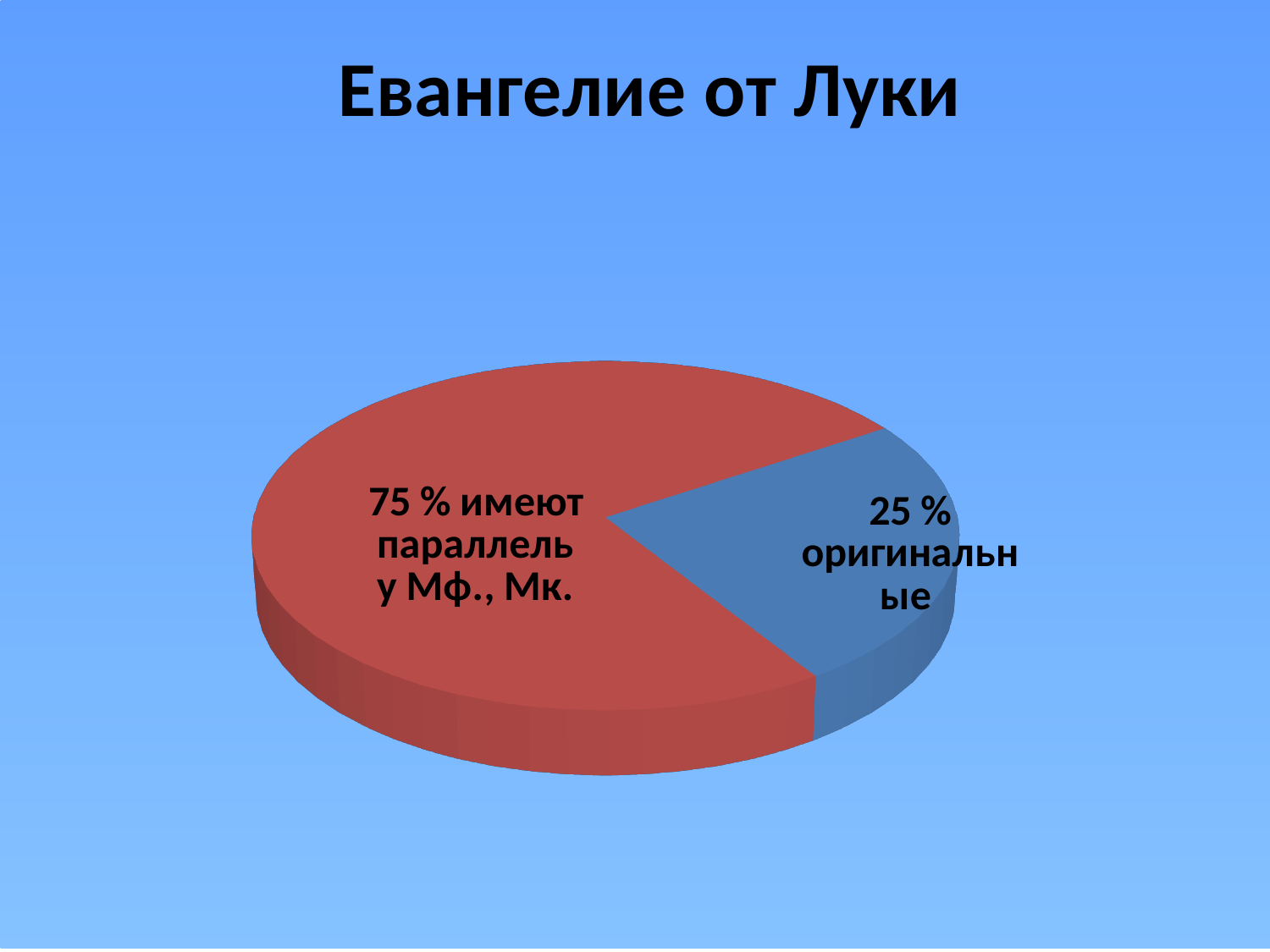
Which slice is the smallest? 25 % оригинальные What is the difference in percentage points between the slice with parallels and the original slice? 50 % How many slices does the pie chart have? 2 What share of the pie is labelled as having parallels in Matthew and Mark (параллель у Мф., Мк.)? 75 % What colour is the slice labelled 25 % оригинальные? blue Which slice is the largest? 75 % имеют параллель у Мф., Мк. Which is larger: the slice with parallels in Matthew and Mark or the original slice? the slice with parallels in Matthew and Mark What share of the pie is labelled as original (оригинальные)? 25 % What kind of chart is shown on the slide? pie chart What is the title of the slide? Евангелие от Луки